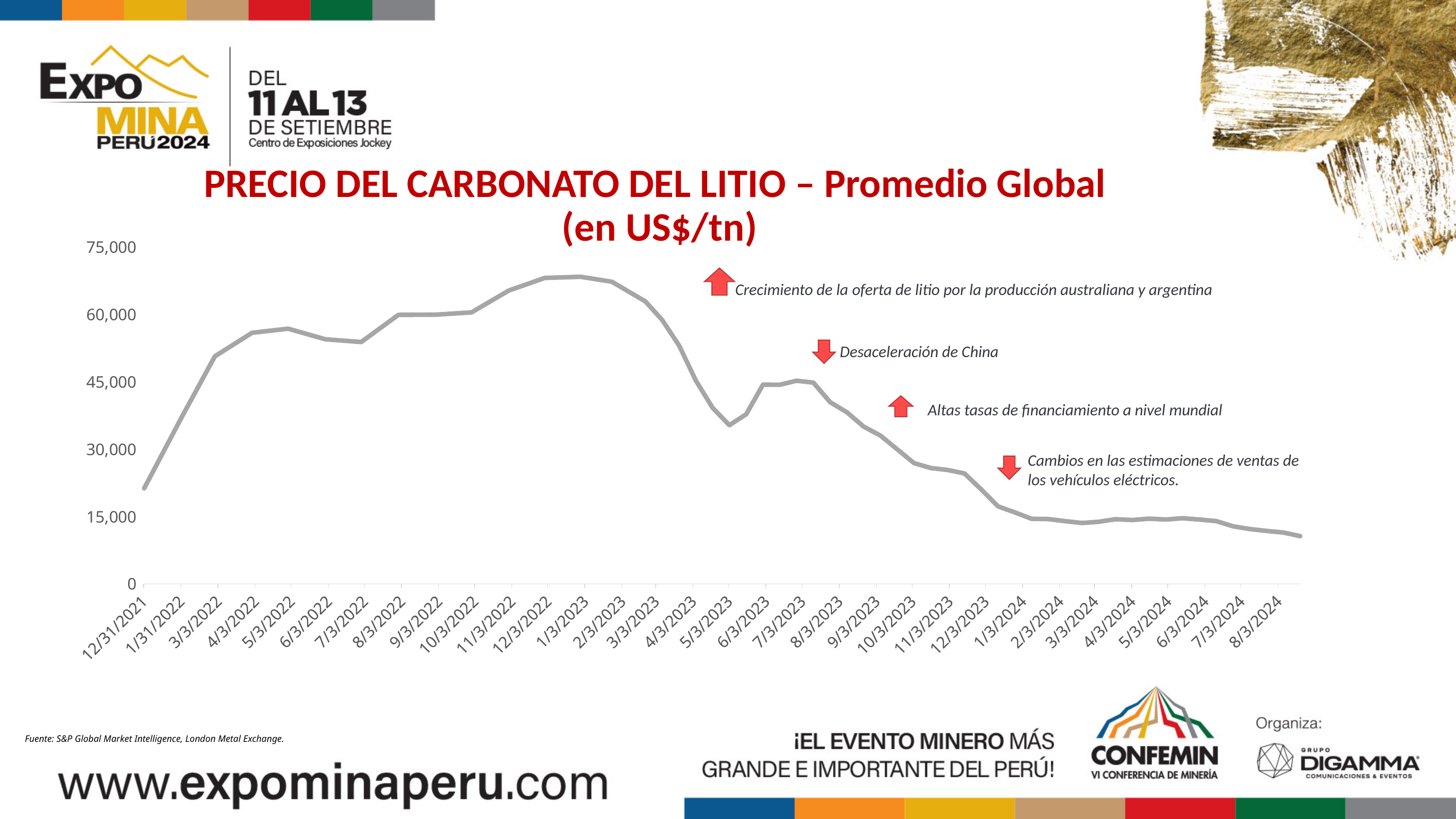
What kind of chart is shown on the slide? line chart Which is larger, the value for 12/31/2021 or the value for 8/3/2024? 12/31/2021 Is the value for 5/3/2023 greater or less than 45,000? less What is the highest value shown on the vertical axis? 75,000 What is the title of the chart? PRECIO DEL CARBONATO DEL LITIO – Promedio Global (en US$/tn) Is the value for 10/3/2023 greater or less than 30,000? less Is the value for 1/3/2023 greater or less than 60,000? greater Do the values rise or fall between 1/3/2023 and 8/3/2024? fall Which date has the lowest value on the chart? 8/3/2024